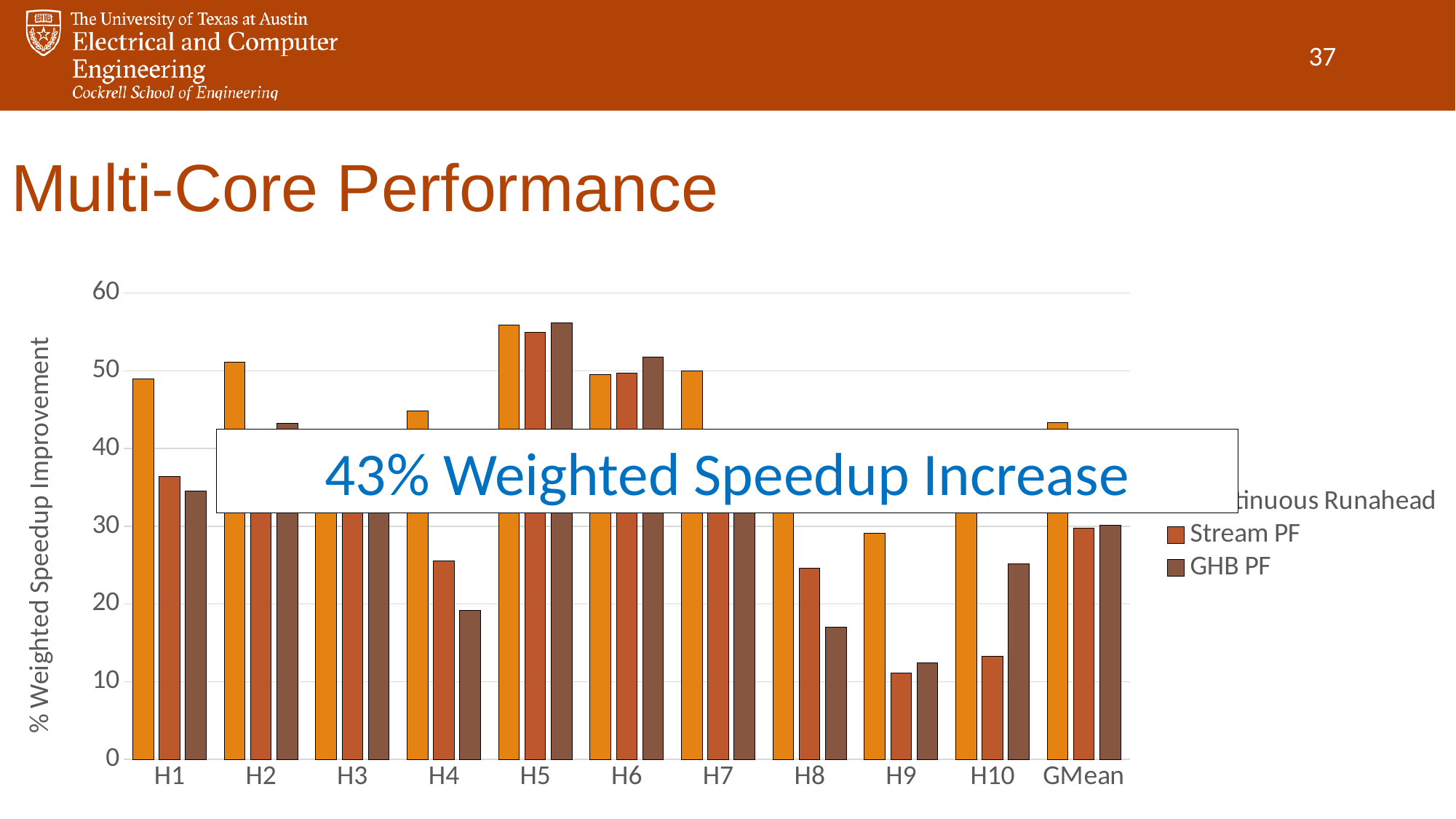
For H4, which is larger: the Stream PF value or the GHB PF value? Stream PF How many series does the chart's legend list? 3 What is the label of the chart's y axis? % Weighted Speedup Improvement For which category is the Stream PF value highest? H5 For H10, which is larger: the Stream PF value or the GHB PF value? GHB PF For which category is the GHB PF value highest? H5 How many categories are shown along the x axis of the chart? 11 For which category is the GHB PF value lowest? H9 What text is shown in the callout box overlaid on the chart? 43% Weighted Speedup Increase What kind of chart is shown on the slide? bar chart Is the GHB PF value for H8 greater or less than 20? less Is the Stream PF value for H1 greater or less than 30? greater